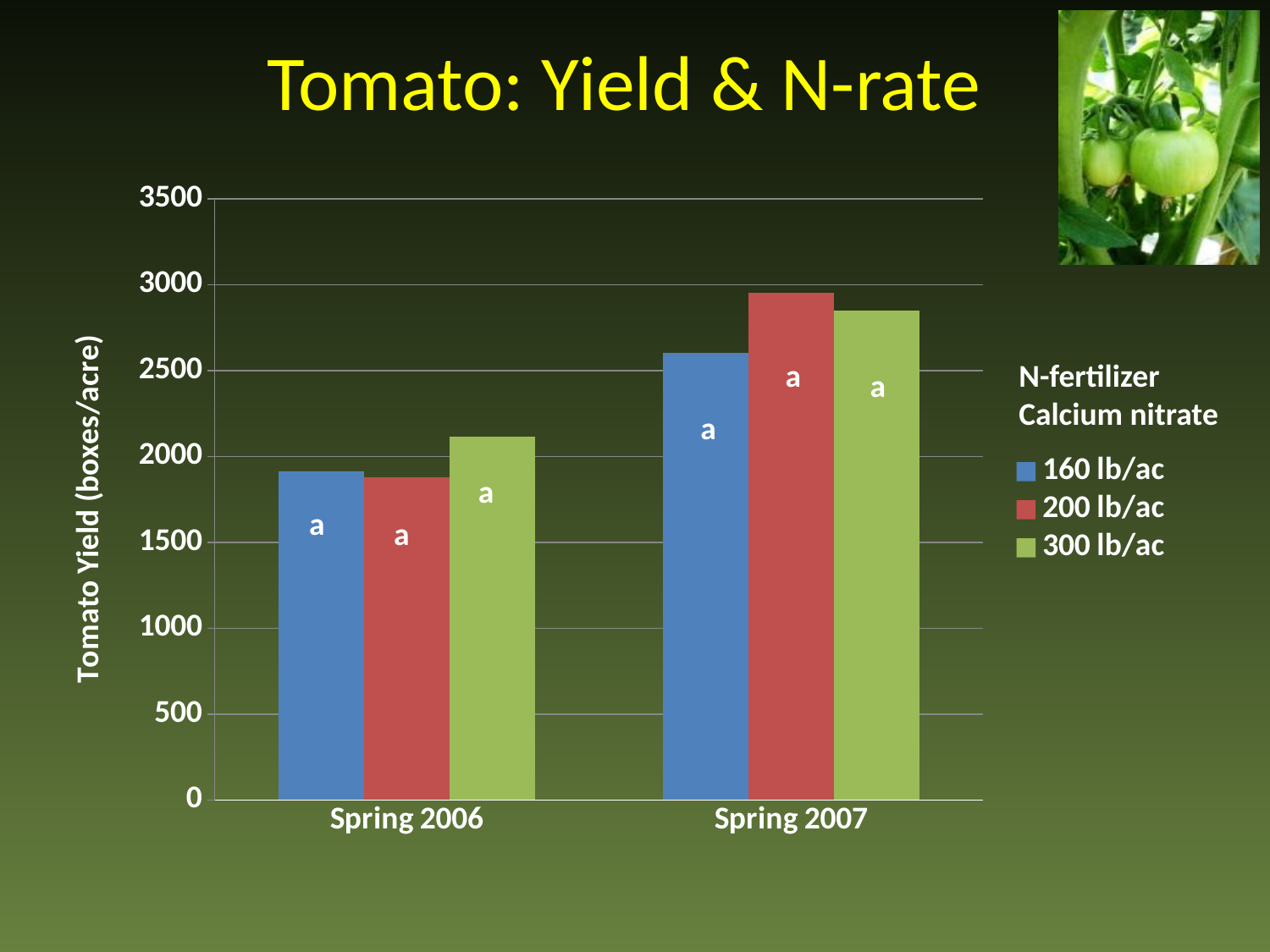
Which N-rate has the highest yield in Spring 2007? 200 lb/ac Is the yield for 300 lb/ac in Spring 2006 greater or less than 2000? greater What is the y-axis label of the chart? Tomato Yield (boxes/acre) What kind of chart is shown on the slide? bar chart Is the yield for 200 lb/ac in Spring 2007 greater or less than 3000? less How many series does the legend list? 3 Which N-rate has the highest yield in Spring 2006? 300 lb/ac How many categories are shown on the x axis? 2 Is the yield for 160 lb/ac in Spring 2007 greater or less than 2500? greater Which is larger, the yield for 160 lb/ac in Spring 2006 or in Spring 2007? Spring 2007 Do the yields for each N-rate rise or fall from Spring 2006 to Spring 2007? rise Which N-rate has the lowest yield in Spring 2007? 160 lb/ac